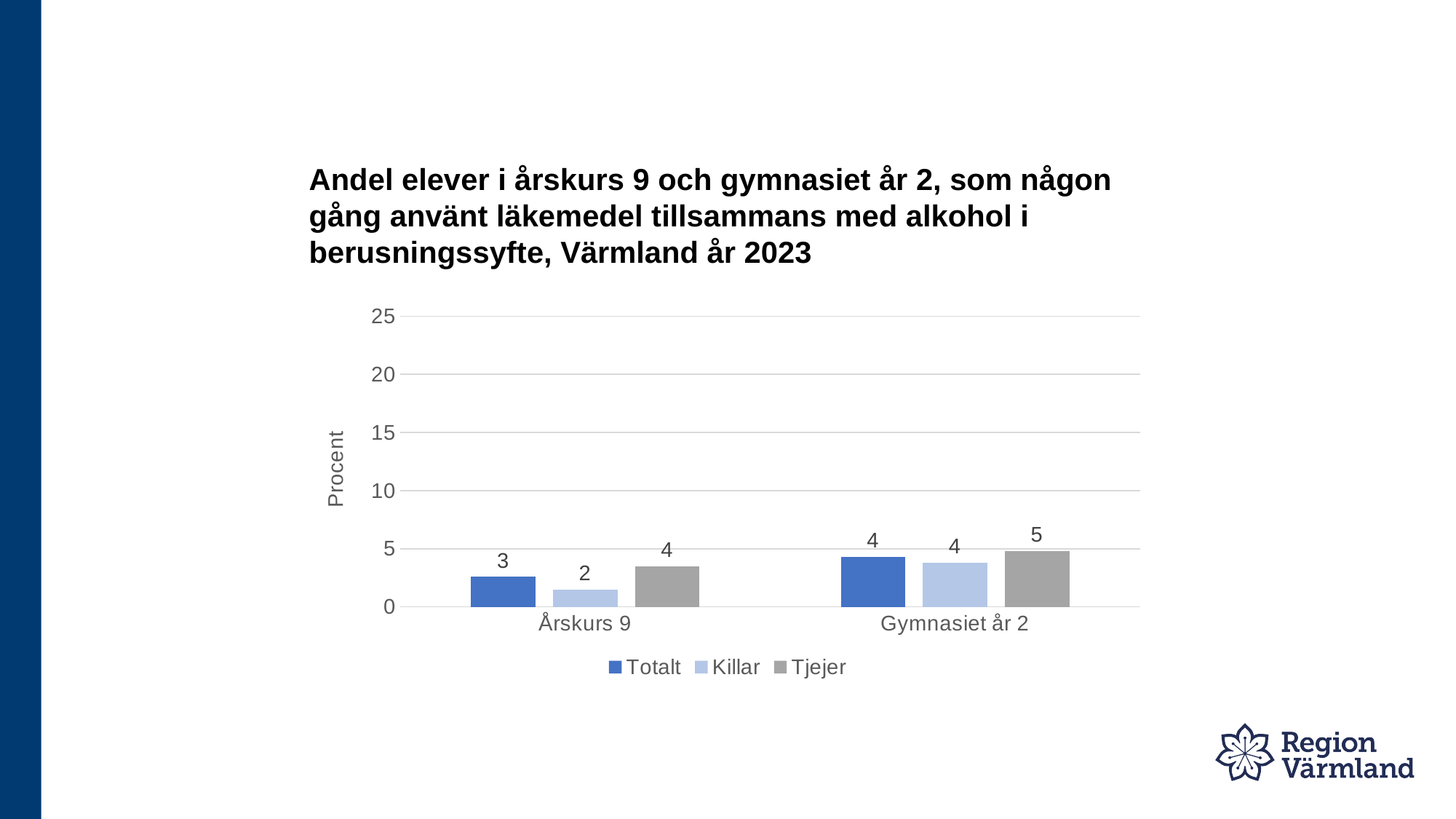
What is the label of the y axis? Procent What is the value for Tjejer in Gymnasiet år 2? 5 What is the value for Killar in Gymnasiet år 2? 4 What is the value for Killar in Årskurs 9? 2 What type of chart is shown on the slide? bar chart What is the difference between Tjejer and Killar in Årskurs 9? 2 Which is larger in Årskurs 9, Tjejer or Killar? Tjejer Is the value for Totalt in Årskurs 9 greater or less than 5? less How many series does the legend list? 3 What is the value for Totalt in Årskurs 9? 3 Which series has the highest value in Gymnasiet år 2? Tjejer Which series has the lowest value in Årskurs 9? Killar